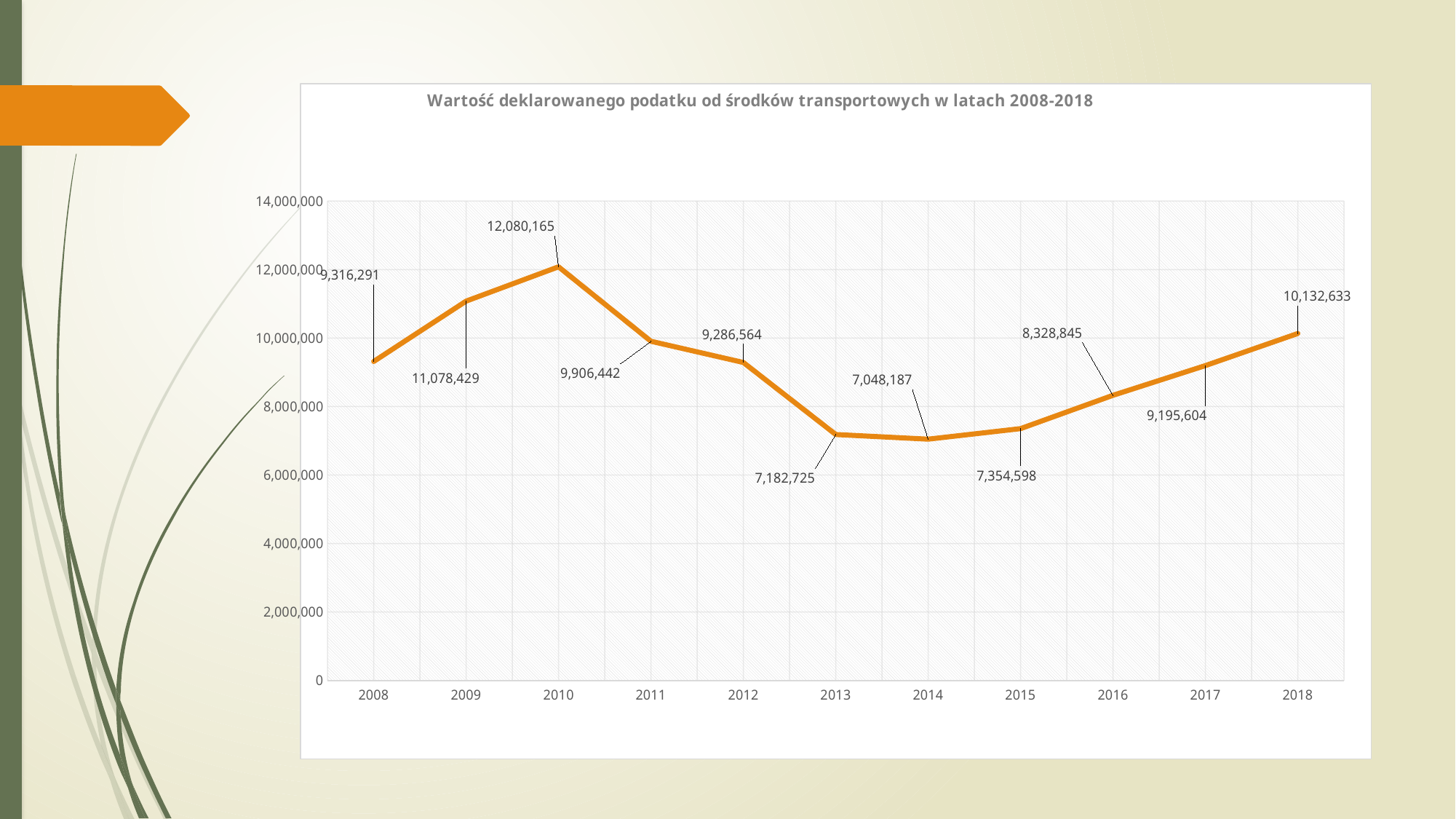
What is the value for 2010? 12,080,165 What is the value for 2014? 7,048,187 What is the difference between the values for 2018 and 2017? 937,029 Which year has the highest value? 2010 What is the value for 2018? 10,132,633 Do the values rise or fall from 2014 to 2018? rise How many years are plotted on the chart? 11 Which is larger, the value for 2011 or the value for 2012? 2011 What kind of chart is shown? line chart What is the value for 2008? 9,316,291 Which year has the lowest value? 2014 What is the difference between the values for 2010 and 2009? 1,001,736